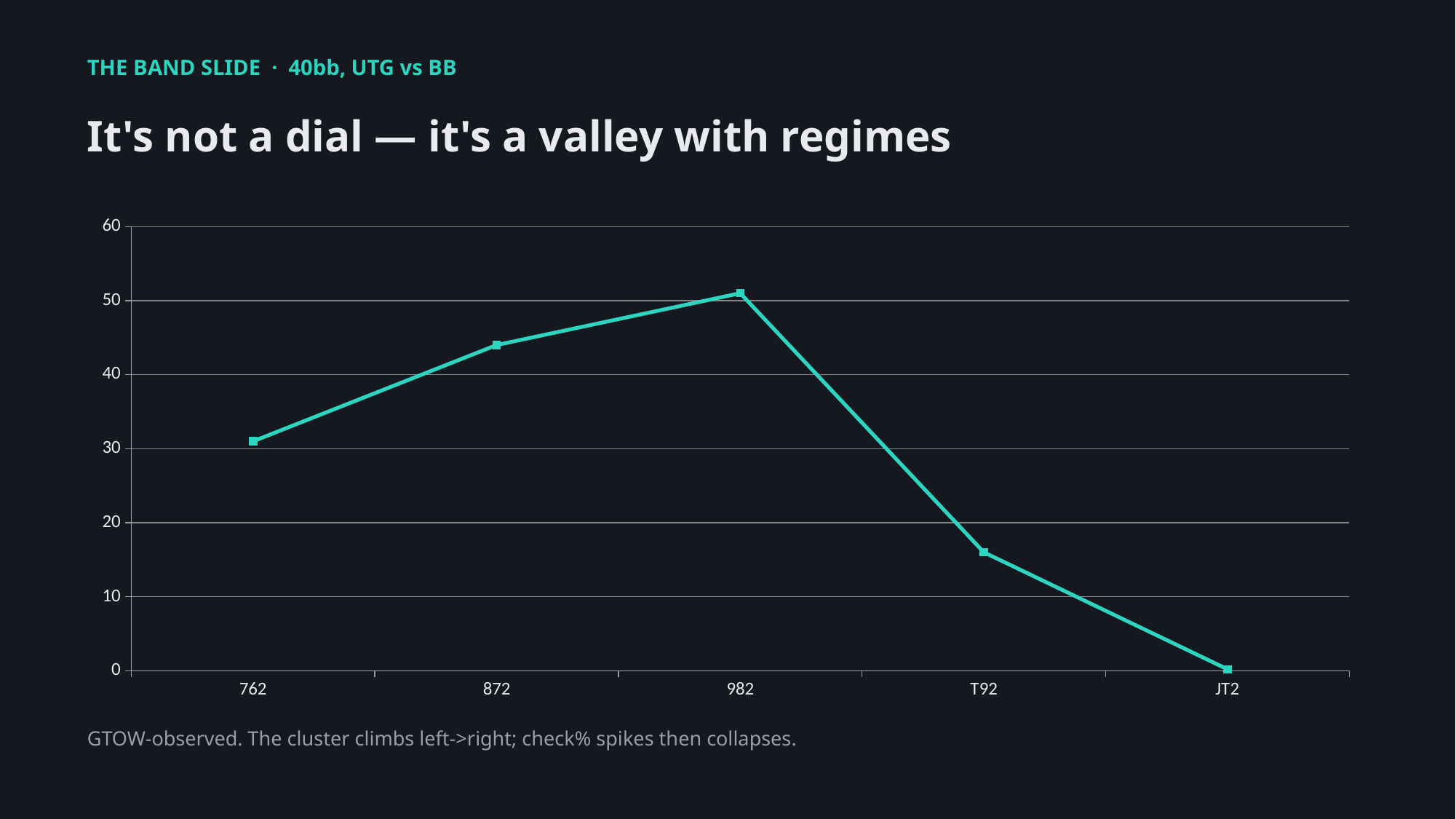
Is the value for 762 greater or less than 40? less What is the title of the slide? It's not a dial — it's a valley with regimes Which has the larger value, 872 or T92? 872 Is the value for 982 greater or less than 40? greater Is the value for T92 greater or less than 20? less Which category has the highest value? 982 Do the values rise or fall from 982 to JT2? fall Which category has the lowest value? JT2 What kind of chart is shown on the slide? line chart How many points are plotted on the line? 5